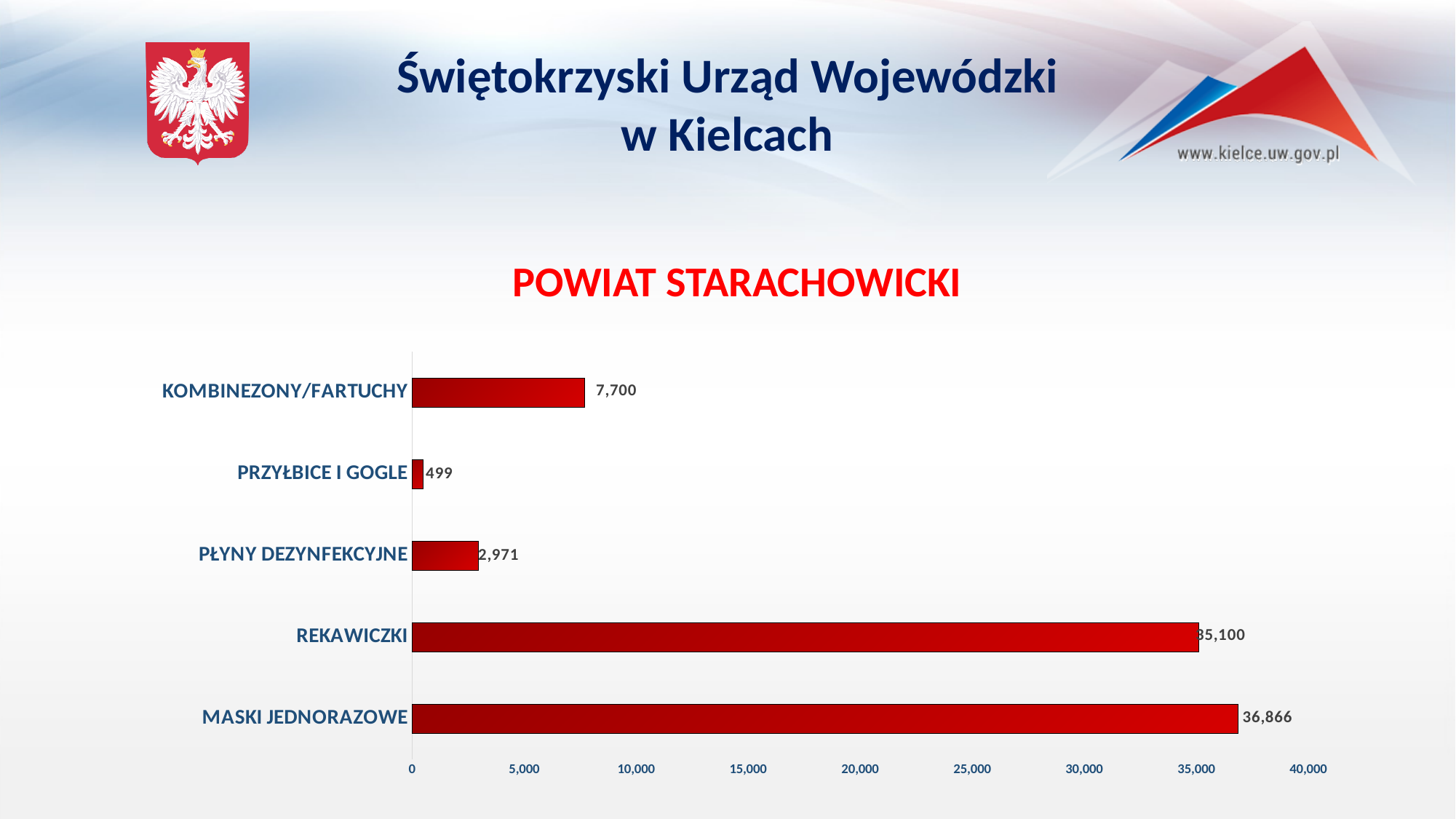
What kind of chart is shown on the slide? bar chart Which is larger, the value for KOMBINEZONY/FARTUCHY or the value for PŁYNY DEZYNFEKCYJNE? KOMBINEZONY/FARTUCHY How many categories are shown in the chart? 5 What is the difference between the values for MASKI JEDNORAZOWE and REKAWICZKI? 1,766 What is the value for KOMBINEZONY/FARTUCHY? 7,700 What is the difference between the values for KOMBINEZONY/FARTUCHY and PŁYNY DEZYNFEKCYJNE? 4,729 Is the value for REKAWICZKI greater or less than 30,000? greater What is the value for PŁYNY DEZYNFEKCYJNE? 2,971 Which category has the lowest value? PRZYŁBICE I GOGLE Which category has the highest value? MASKI JEDNORAZOWE What is the value for MASKI JEDNORAZOWE? 36,866 What is the value for PRZYŁBICE I GOGLE? 499